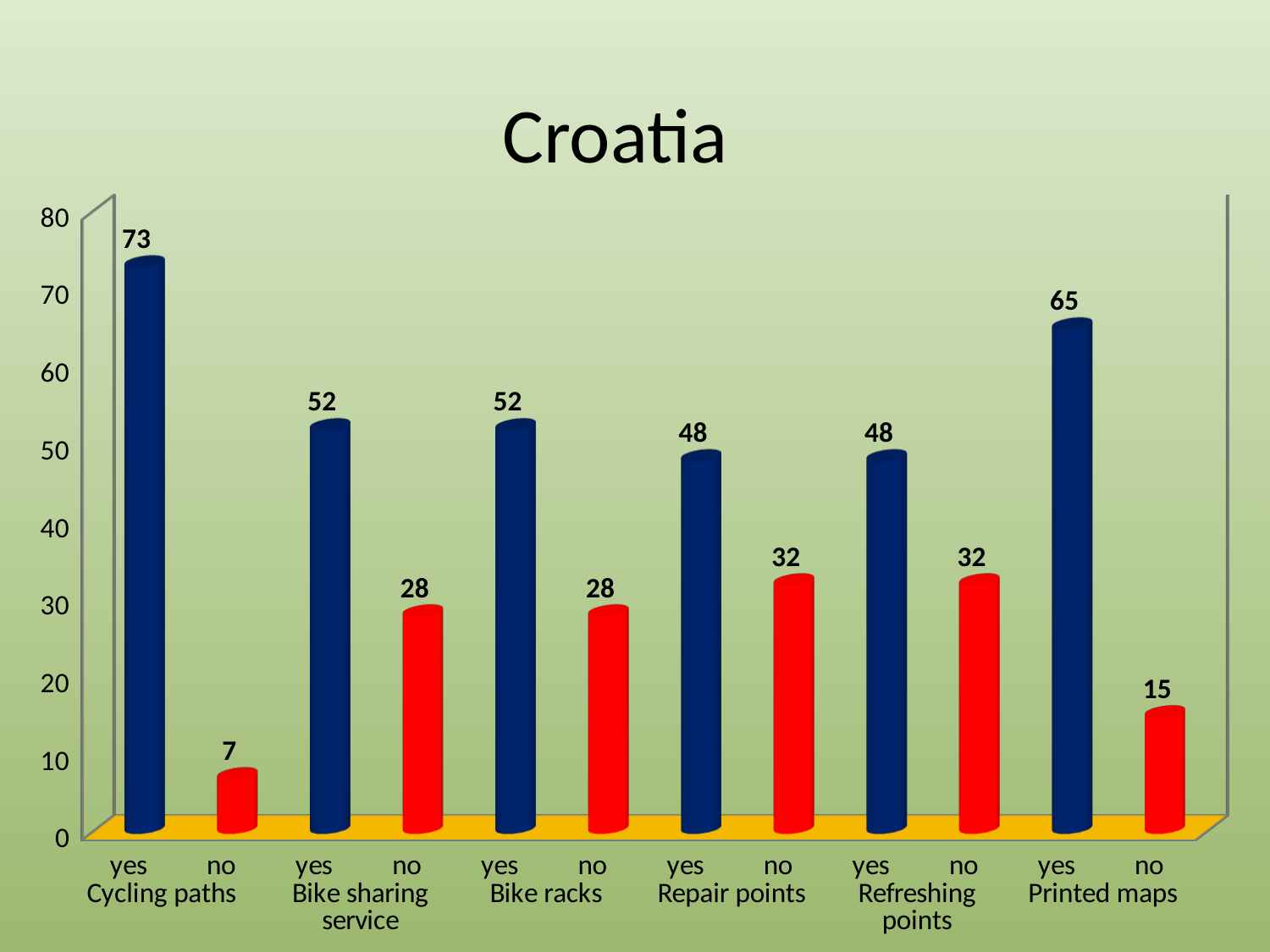
What is the value for 'yes' under Cycling paths? 73 Which bar has the lowest value on the chart? no, Cycling paths What is the value for 'no' under Repair points? 32 What is the difference between the 'yes' and 'no' values for Printed maps? 50 What is the title of the chart? Croatia What kind of chart is shown on the slide? bar chart What is the value for 'no' under Printed maps? 15 Which bar has the highest value on the chart? yes, Cycling paths How many categories (facilities) are shown along the x axis? 6 What is the difference between the 'yes' values for Cycling paths and Bike racks? 21 How many bars are plotted on the chart? 12 Which is larger: the 'yes' value for Repair points or the 'yes' value for Printed maps? Printed maps